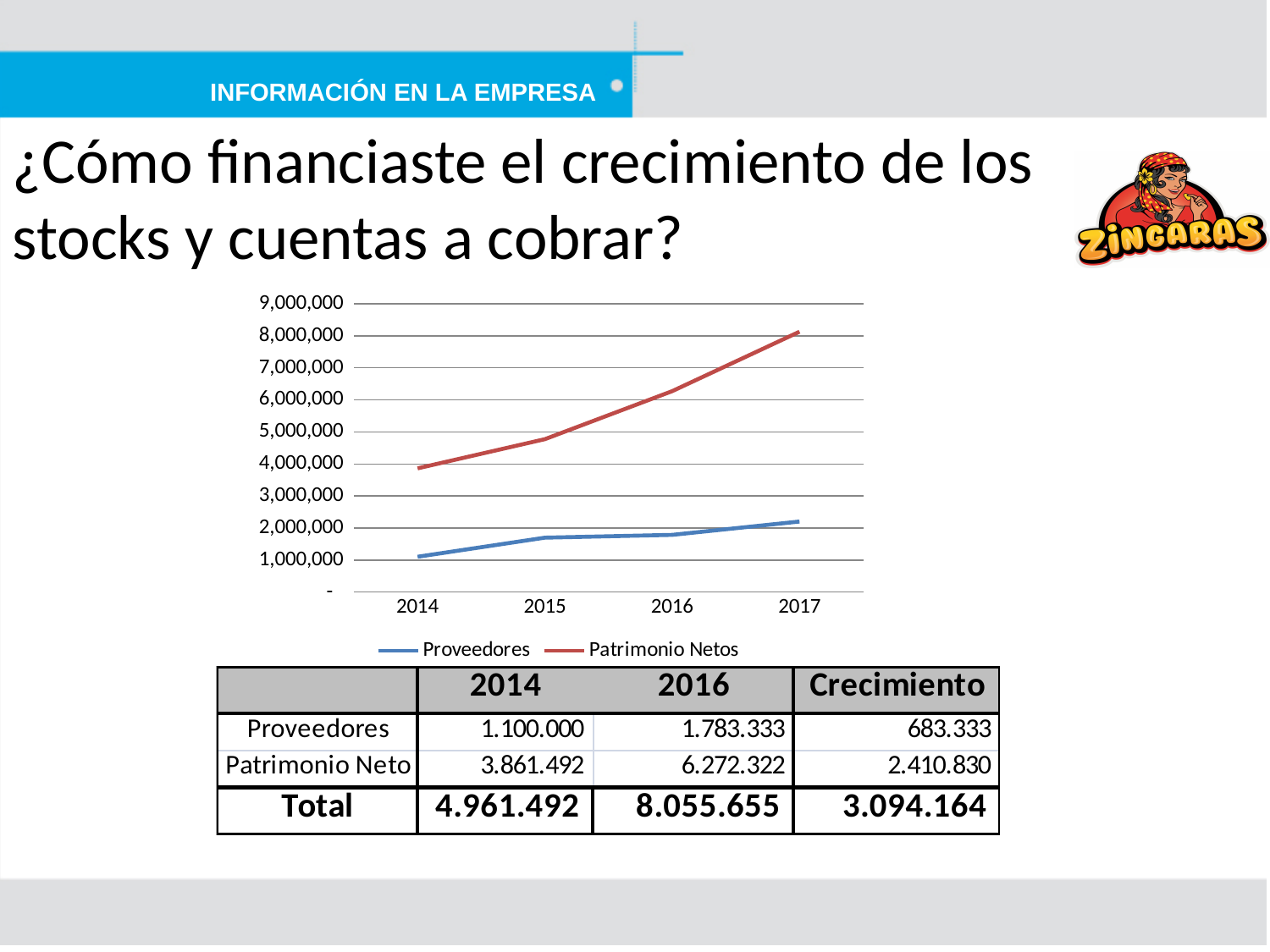
Does the Patrimonio Netos line rise or fall from 2014 to 2017? rise In 2017, which series has the larger value, Proveedores or Patrimonio Netos? Patrimonio Netos How many years are plotted along the x axis of the chart? 4 In which year is the Proveedores series at its lowest value? 2014 Does the Proveedores line rise or fall from 2014 to 2017? rise How many series does the chart legend list? 2 Is the value for Proveedores in 2014 greater or less than 2,000,000? less In which year does the Patrimonio Netos series reach its highest value? 2017 What kind of chart is shown on the slide? line chart Is the value for Patrimonio Netos in 2015 greater or less than 4,000,000? greater Is the value for Patrimonio Netos in 2017 greater or less than 7,000,000? greater What colour is the Patrimonio Netos line in the chart? red